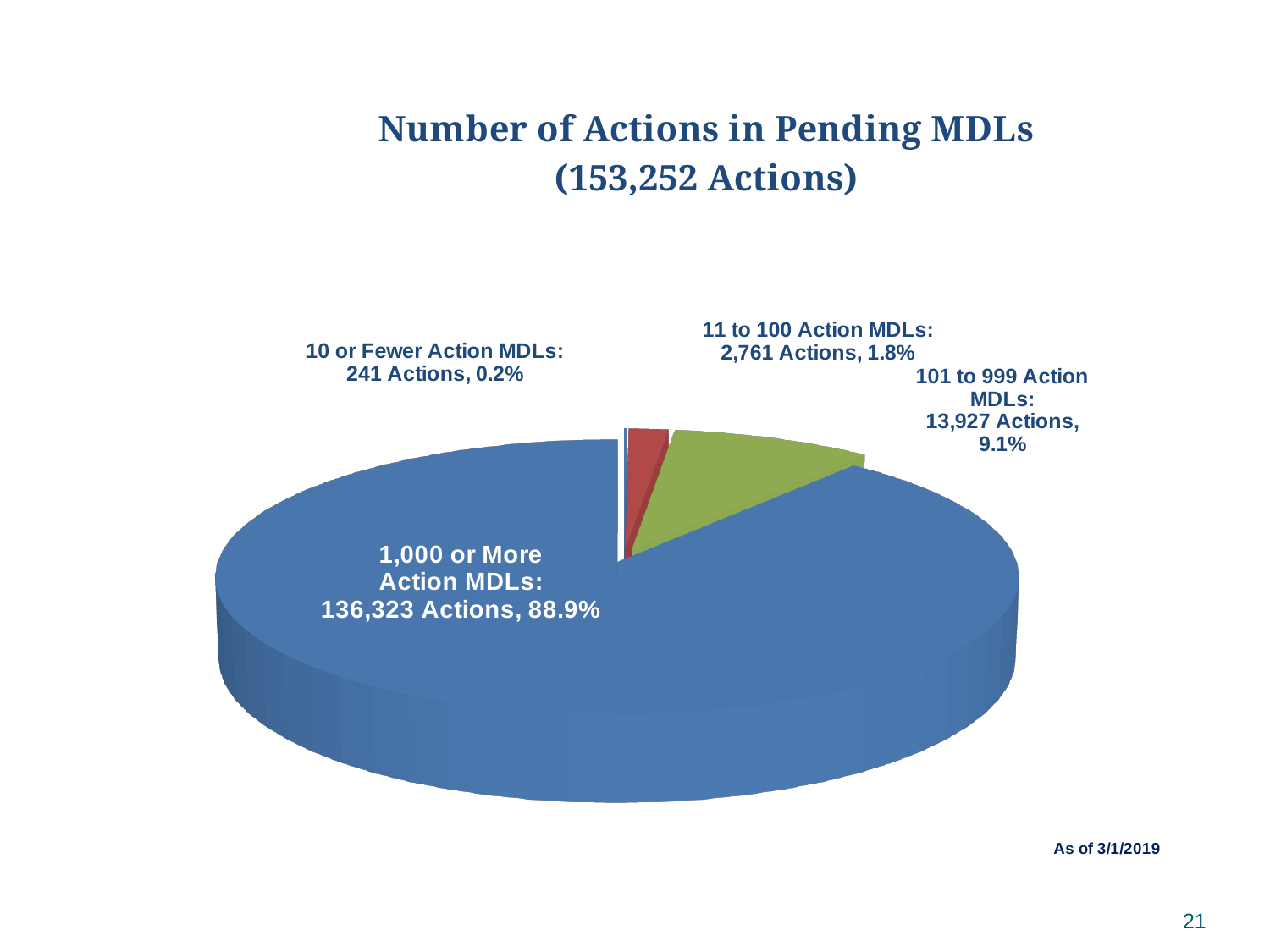
What share of the pie do 1,000 or More Action MDLs represent? 88.9% What kind of chart is shown on the slide? Pie chart Which has more actions: 11 to 100 Action MDLs or 10 or Fewer Action MDLs? 11 to 100 Action MDLs How many actions are in 10 or Fewer Action MDLs? 241 How many actions are in 101 to 999 Action MDLs? 13,927 How many actions are in 1,000 or More Action MDLs? 136,323 How many actions are in 11 to 100 Action MDLs? 2,761 What is the difference in actions between 101 to 999 Action MDLs and 11 to 100 Action MDLs? 11,166 What share of the pie do 101 to 999 Action MDLs represent? 9.1% Which category has the largest number of actions? 1,000 or More Action MDLs Which category has the smallest number of actions? 10 or Fewer Action MDLs How many categories does the pie chart show? 4